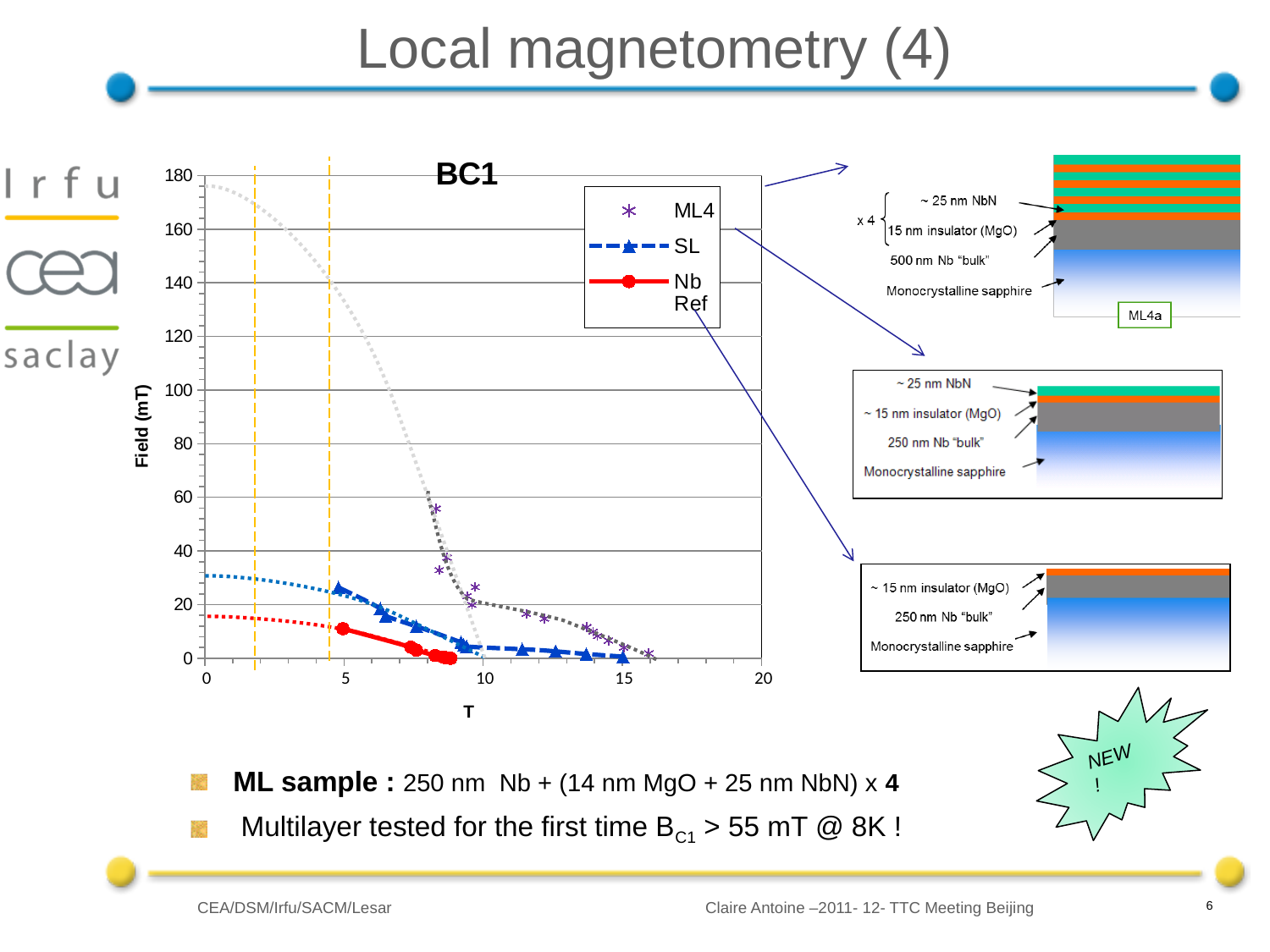
What is the title of the chart? BC1 What is the label of the horizontal axis of the chart? T At T = 5, is the value of the SL series larger or smaller than the value of the Nb Ref series? larger Do the values of the SL series rise or fall as T increases? fall How many series does the chart legend list? 3 Is the value of the Nb Ref series at T = 5 greater or less than 20 mT? less What is the label of the vertical axis of the chart? Field (mT) Is the highest ML4 point near T = 8 greater or less than 40 mT? greater What kind of chart is shown on the slide? line chart What are the three series named in the chart legend? ML4, SL, Nb Ref Which series has the lowest field values in the chart? Nb Ref Which series reaches the highest field values in the chart? ML4